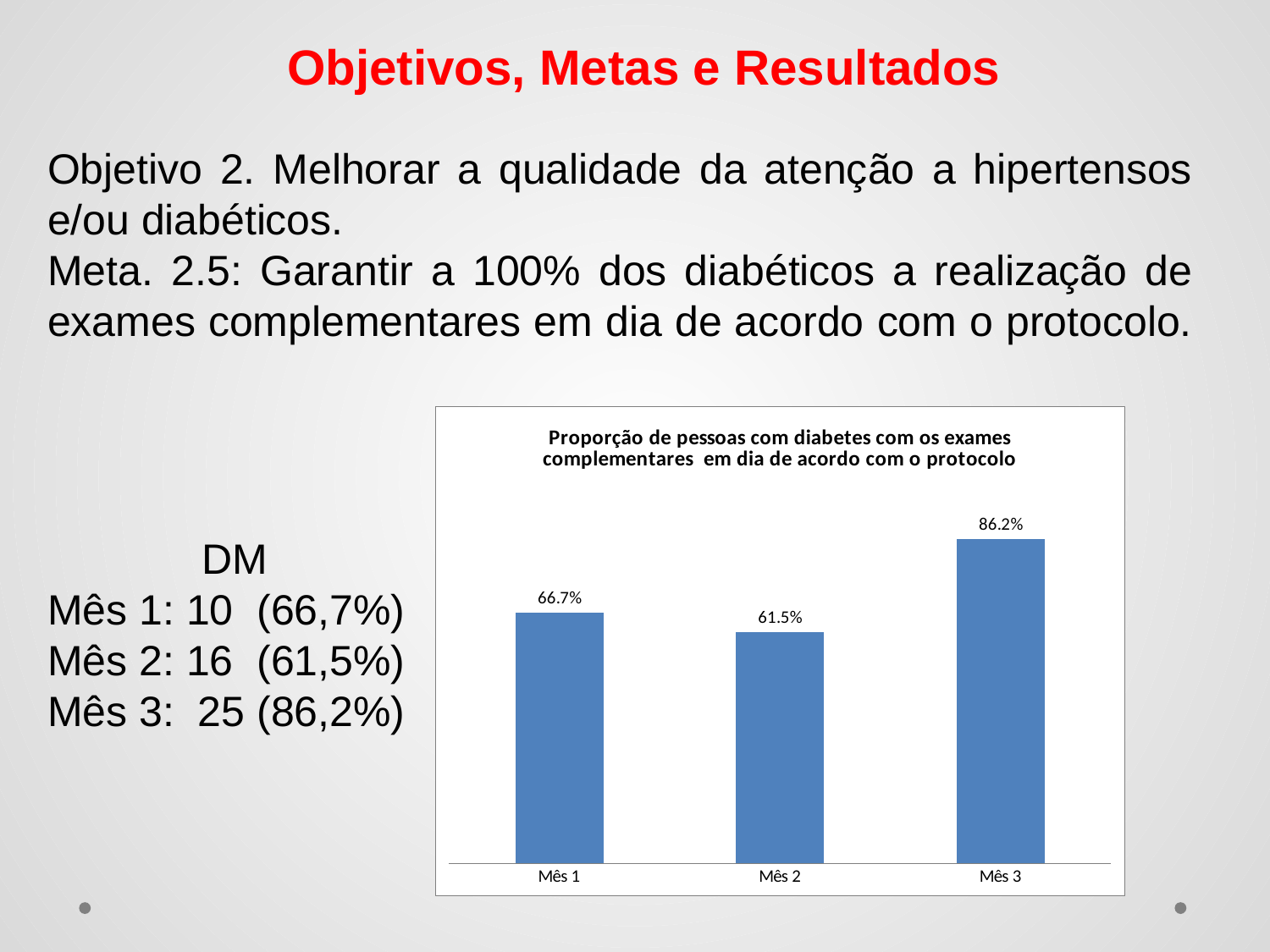
Which month has the lowest value? Mês 2 How many months are shown on the chart? 3 Does the value rise or fall from Mês 2 to Mês 3? Rise What kind of chart is shown on the slide? Bar chart What is the value for Mês 1? 66.7% What is the value for Mês 3? 86.2% What is the value for Mês 2? 61.5% Which month has the highest value? Mês 3 What is the difference between the values for Mês 3 and Mês 1? 19.5% What is the difference between the values for Mês 1 and Mês 2? 5.2% Which is larger, the value for Mês 1 or Mês 2? Mês 1 What is the title of the chart? Proporção de pessoas com diabetes com os exames complementares em dia de acordo com o protocolo